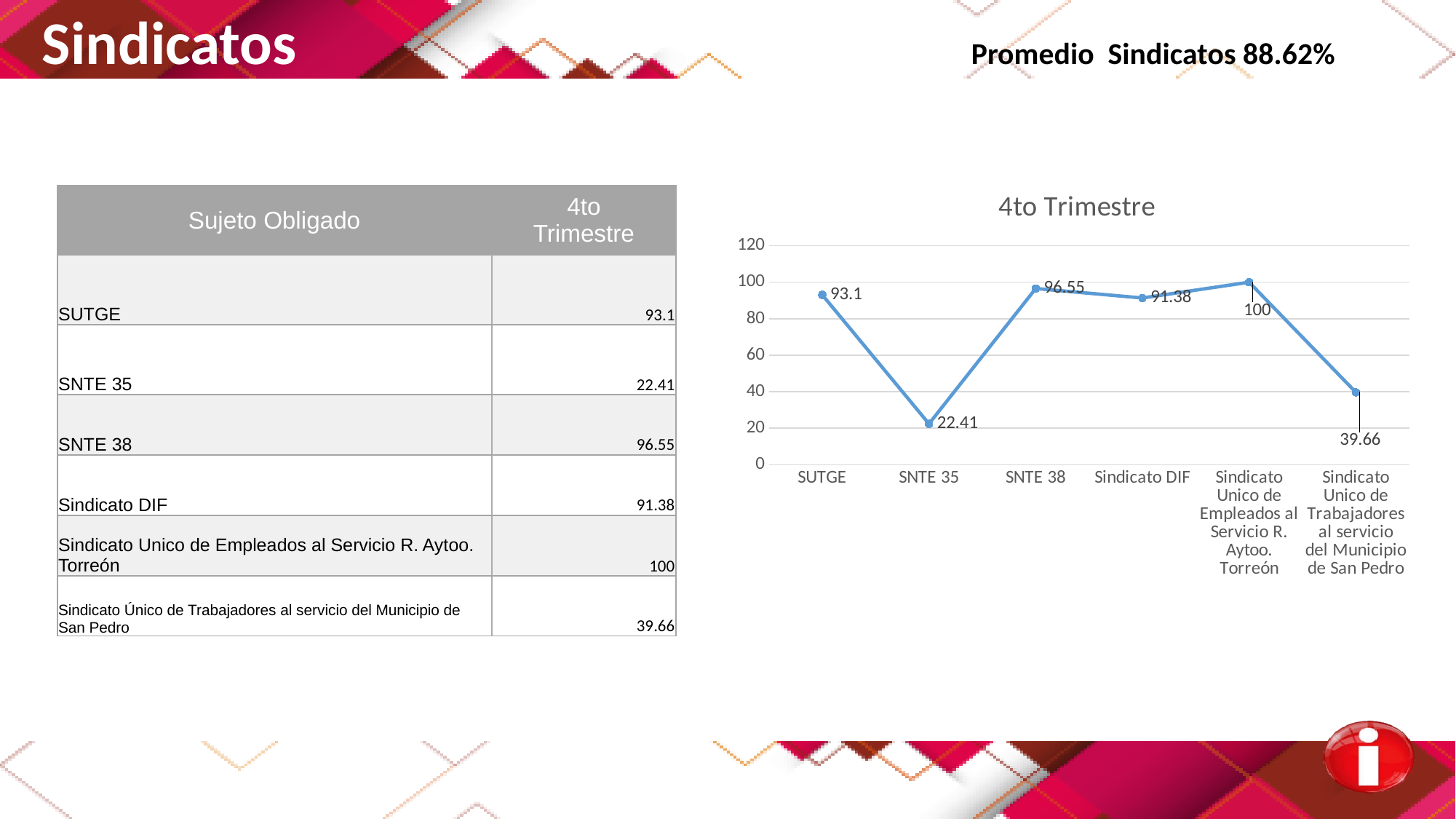
How many categories are plotted in the 4to Trimestre chart? 6 What is the value for SNTE 35 in the 4to Trimestre chart? 22.41 Which category has the highest value in the 4to Trimestre chart? Sindicato Unico de Empleados al Servicio R. Aytoo. Torreón What is the difference between the values for SNTE 38 and SNTE 35? 74.14 Is the value for SNTE 35 greater or less than 40? less What is the value for Sindicato DIF in the 4to Trimestre chart? 91.38 What kind of chart is shown on the slide? line chart What is the value for SUTGE in the 4to Trimestre chart? 93.1 What is the title of the chart on the slide? 4to Trimestre What is the value for Sindicato Unico de Trabajadores al servicio del Municipio de San Pedro in the chart? 39.66 Which is larger, the value for SUTGE or the value for Sindicato DIF? SUTGE Which category has the lowest value in the 4to Trimestre chart? SNTE 35